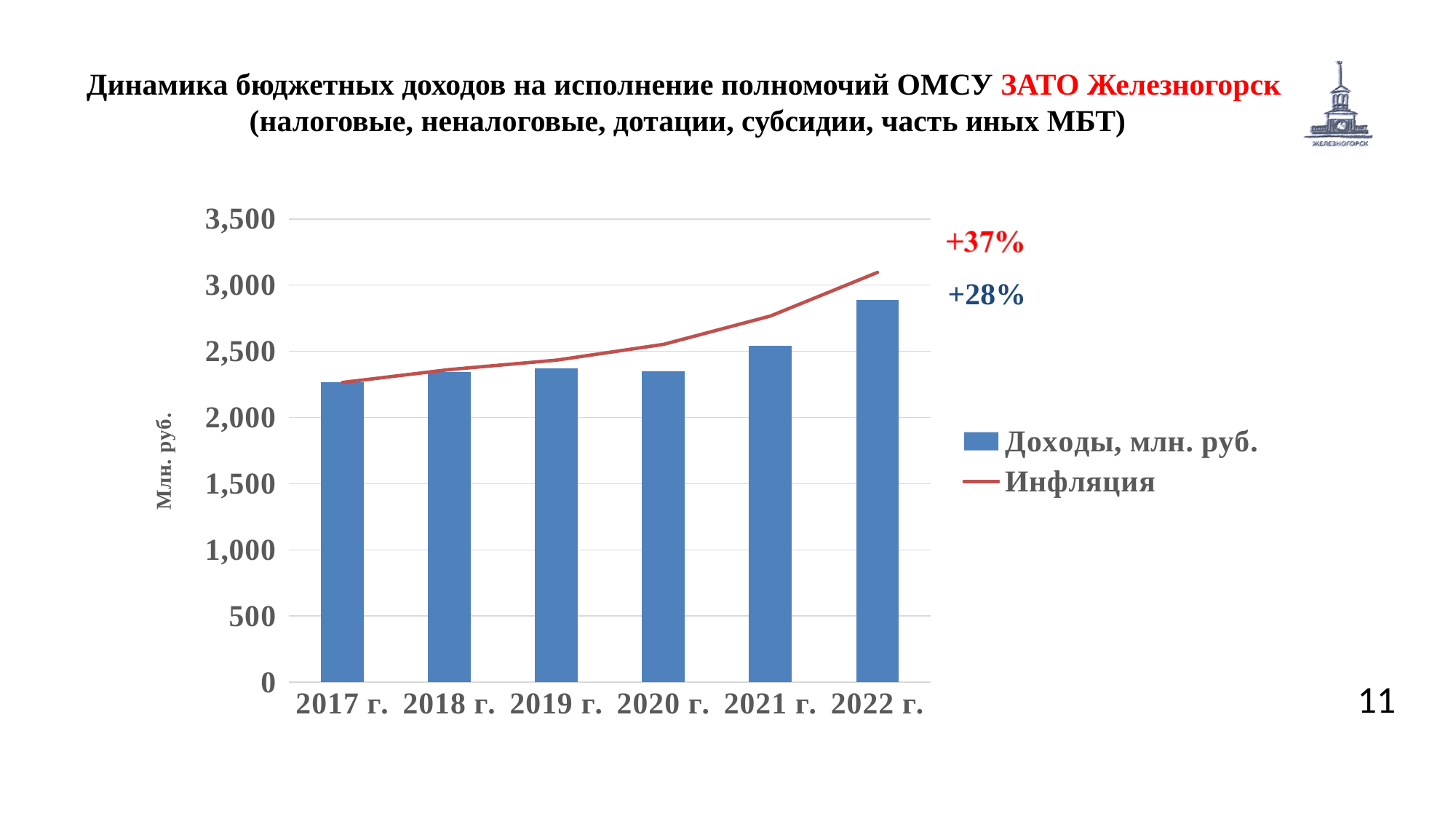
Which is larger, the Доходы value for 2021 г. or for 2020 г.? 2021 г. How many years are shown on the x axis of the chart? 6 Is the value for Доходы in 2022 г. greater or less than 2,500? greater Which year has the highest value for Доходы, млн. руб.? 2022 г. Do the Доходы values rise or fall from 2017 г. to 2022 г. overall? rise Is the value for Доходы in 2017 г. greater or less than 2,000? greater Which year has the lowest value for Доходы, млн. руб.? 2017 г. How many series does the chart legend list? 2 Is the value for Доходы in 2020 г. greater or less than 2,500? less What kind of chart is used to show Доходы, млн. руб.? bar chart What is the label on the vertical axis of the chart? Млн. руб.